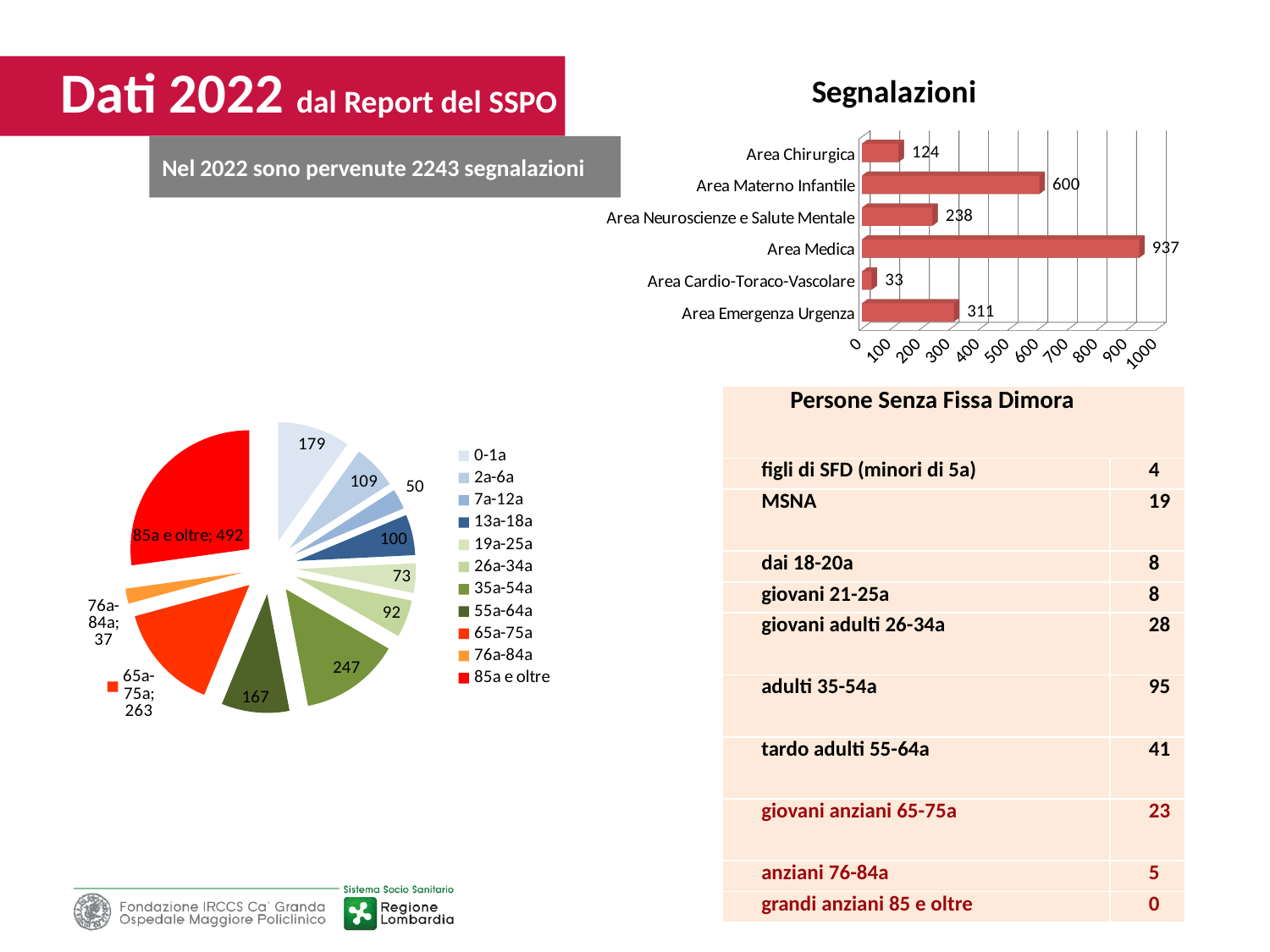
How many areas are shown in the Segnalazioni bar chart? 6 In the pie chart on the left, which age group has the largest slice? 85a e oltre In the Segnalazioni bar chart, which area has the highest value? Area Medica In the Segnalazioni bar chart, what is the value for Area Medica? 937 In the Segnalazioni bar chart, what is the difference between Area Materno Infantile and Area Emergenza Urgenza? 289 In the pie chart on the left, what is the value for the 35a-54a age group? 247 What kind of chart is the Segnalazioni chart? bar chart In the Segnalazioni bar chart, which area has the lowest value? Area Cardio-Toraco-Vascolare In the pie chart on the left, which age group has the smallest slice? 76a-84a In the Segnalazioni bar chart, what is the value for Area Cardio-Toraco-Vascolare? 33 How many entries does the legend of the pie chart on the left list? 11 In the Segnalazioni bar chart, which is larger: Area Neuroscienze e Salute Mentale or Area Chirurgica? Area Neuroscienze e Salute Mentale